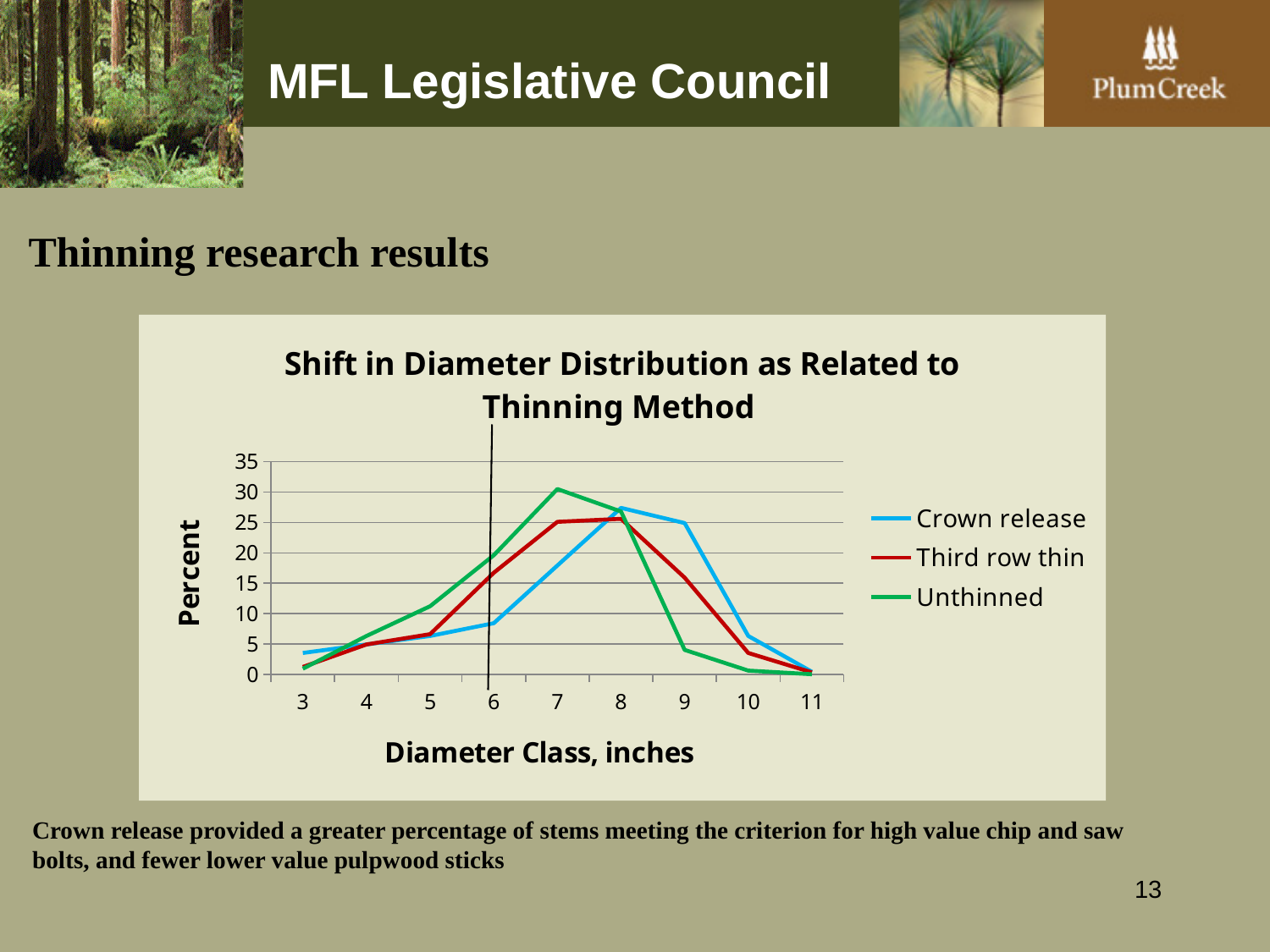
Does the Crown release series rise or fall from diameter class 8 to diameter class 11? Fall At diameter class 9, which is larger: Crown release or Unthinned? Crown release Is the Crown release value at diameter class 6 greater or less than 10? less What is the title of the x axis? Diameter Class, inches Is the Unthinned value at diameter class 7 greater or less than 25? greater At diameter class 5, which is larger: Unthinned or Crown release? Unthinned What kind of chart is shown on the slide? Line chart How many series does the legend list? 3 Which series reaches the highest peak value on the chart? Unthinned How many diameter classes are shown along the x axis? 9 Is the Third row thin value at diameter class 9 greater or less than 10? greater At which diameter class does the Unthinned series reach its highest value? 7